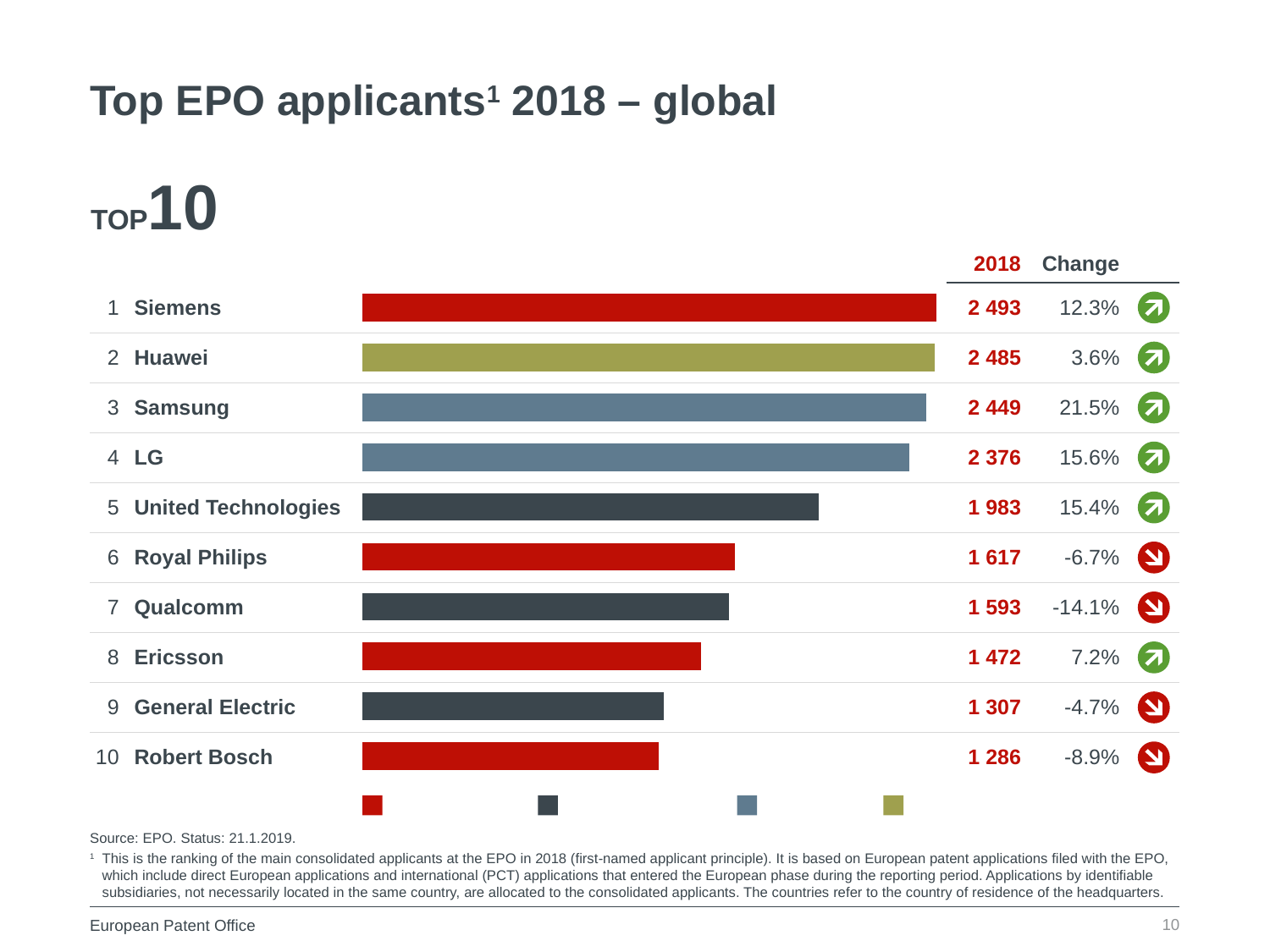
Which applicant has the highest 2018 value? Siemens What is the change shown for Samsung? 21.5% How many applicants are listed in the chart? 10 What kind of chart is shown on the slide? Bar chart What is the 2018 value for Qualcomm? 1 593 Which applicant shows the largest negative change? Qualcomm What is the difference between the 2018 values for Siemens and Huawei? 8 Which has a larger 2018 value, Royal Philips or Ericsson? Royal Philips Which applicant has the lowest 2018 value? Robert Bosch What colour is the bar for Huawei? Olive green What is the difference between the 2018 values for LG and United Technologies? 393 What is the 2018 value for Siemens? 2 493